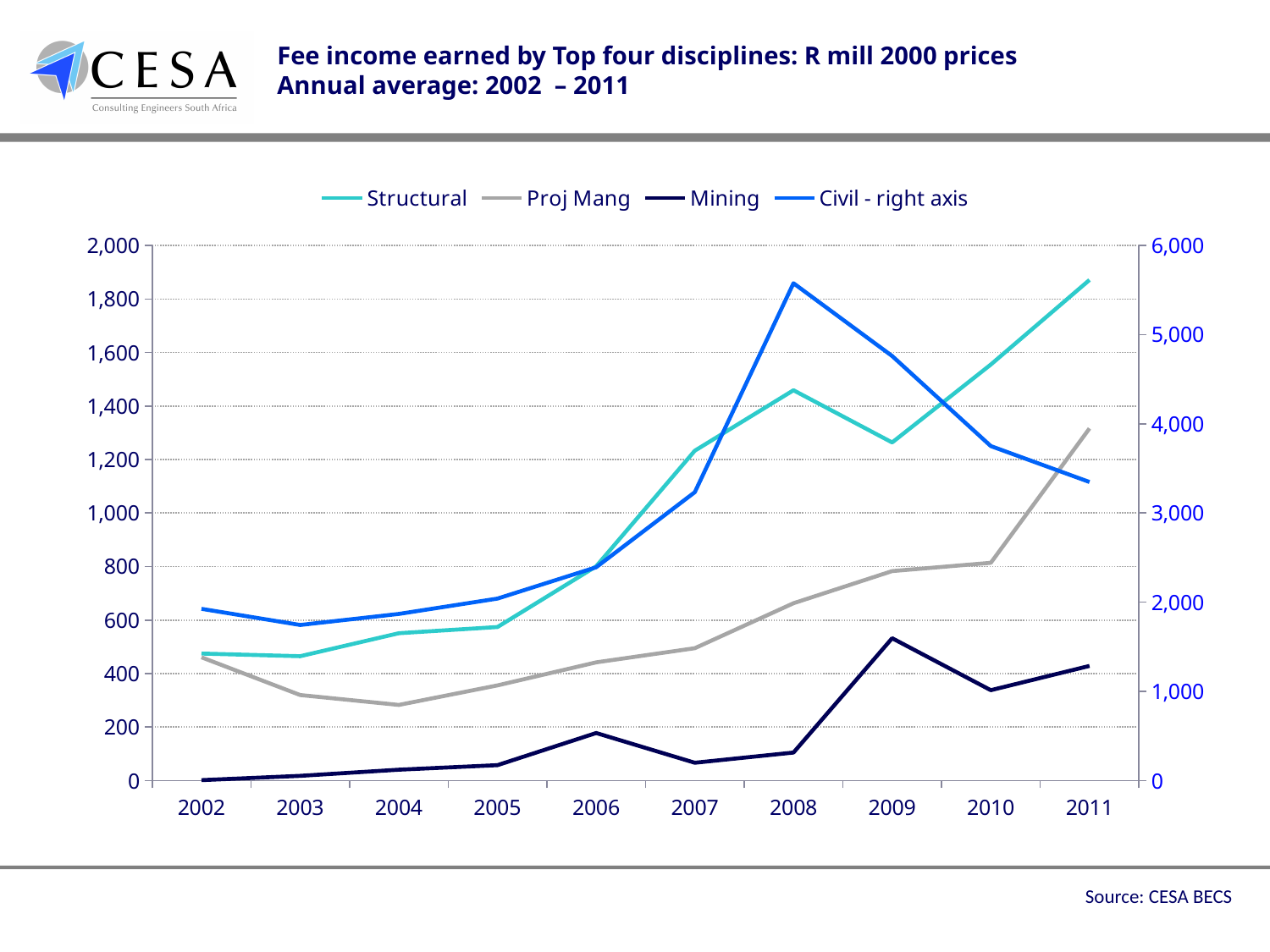
In 2008, which is larger: the Structural value or the Proj Mang value? Structural What kind of chart is shown on the slide? line chart In which year is the Proj Mang series at its lowest? 2004 How many years are shown along the x axis? 10 In which year does the Mining series reach its highest value? 2009 Does the Proj Mang series rise or fall from 2009 to 2011? rise Is the Structural value for 2011 greater or less than 1,800? greater How many series does the legend list? 4 In which year does the Structural series reach its highest value? 2011 In which year does the Civil series reach its highest value? 2008 On the right axis, is the Civil value for 2008 greater or less than 5,000? greater Which series is plotted against the right axis? Civil